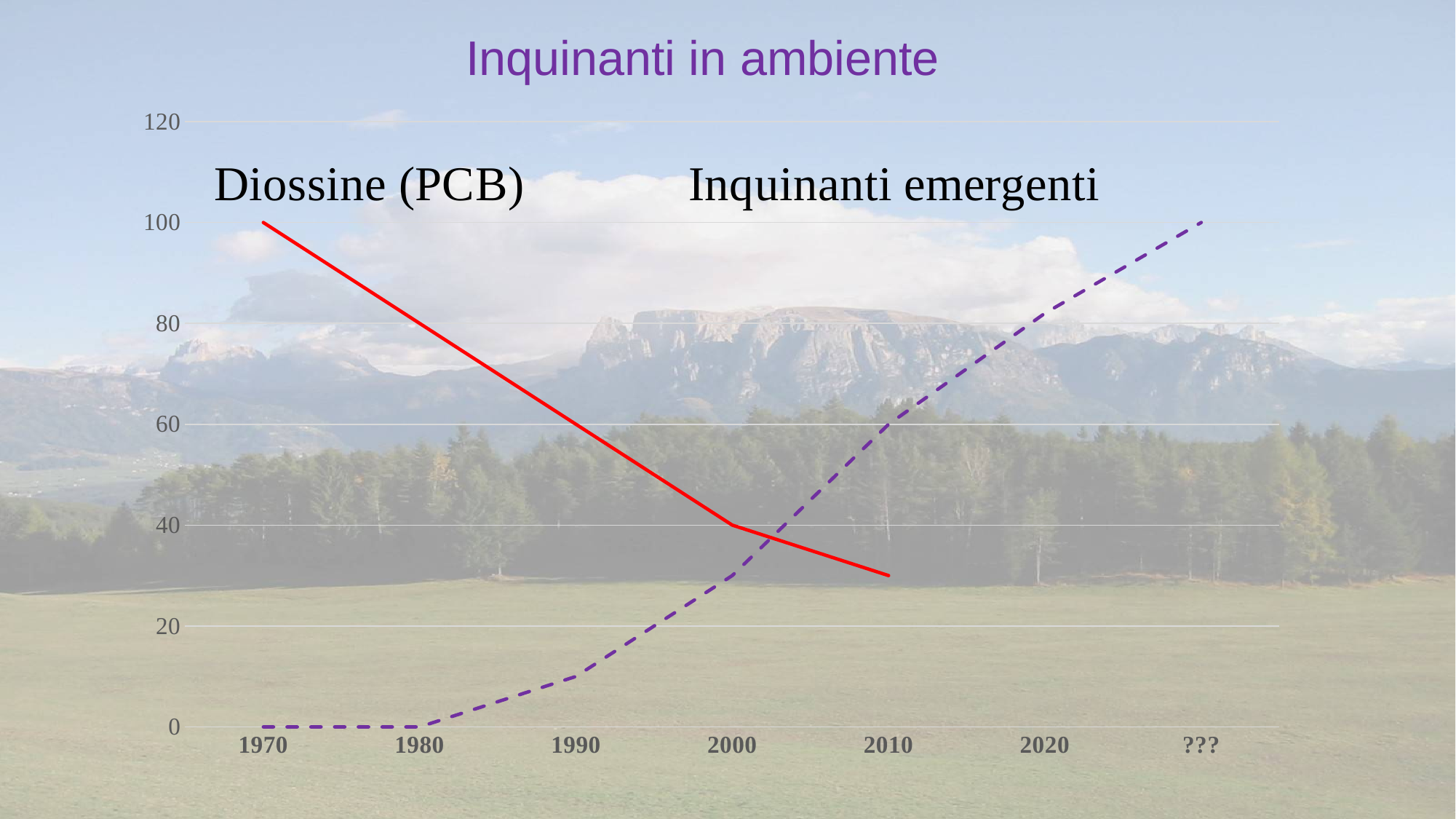
Is the value for Inquinanti emergenti in 2020 greater or less than 60? greater What is the value of Diossine (PCB) in 1970? 100 What is the value of Inquinanti emergenti in 1980? 0 Does the Inquinanti emergenti line rise or fall from 1980 onwards? rise What is the value of Diossine (PCB) in 2000? 40 What kind of chart is shown on the slide? line chart By how much does the Diossine (PCB) value fall between 1970 and 2000? 60 Is the value for Diossine (PCB) in 2010 greater or less than 40? less What is the value of Inquinanti emergenti in 1970? 0 In 1990, which series has the higher value, Diossine (PCB) or Inquinanti emergenti? Diossine (PCB) How many series are plotted on the chart? 2 Does the Diossine (PCB) line rise or fall from 1970 to 2010? fall